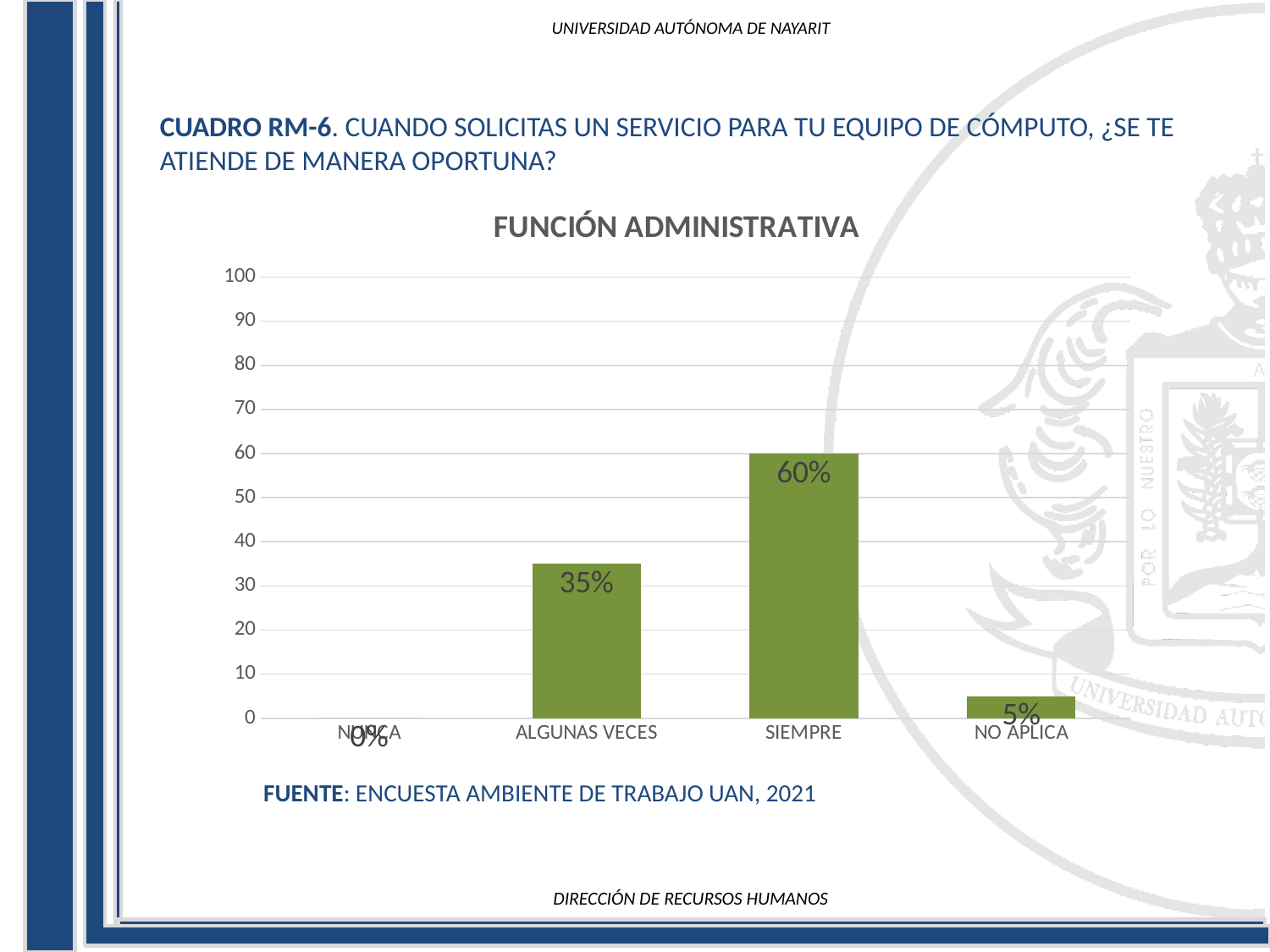
What is the value for NO APLICA? 5% Which category has the highest value? SIEMPRE What is the value for SIEMPRE? 60% What is the difference between the values for SIEMPRE and ALGUNAS VECES? 25% What is the title of the chart? FUNCIÓN ADMINISTRATIVA What is the value for NUNCA? 0% What is the value for ALGUNAS VECES? 35% What kind of chart is shown? bar chart How many categories are shown on the x axis? 4 Which category has the lowest value? NUNCA Is the value for SIEMPRE greater or less than 50? greater Which is larger, the value for ALGUNAS VECES or the value for NO APLICA? ALGUNAS VECES